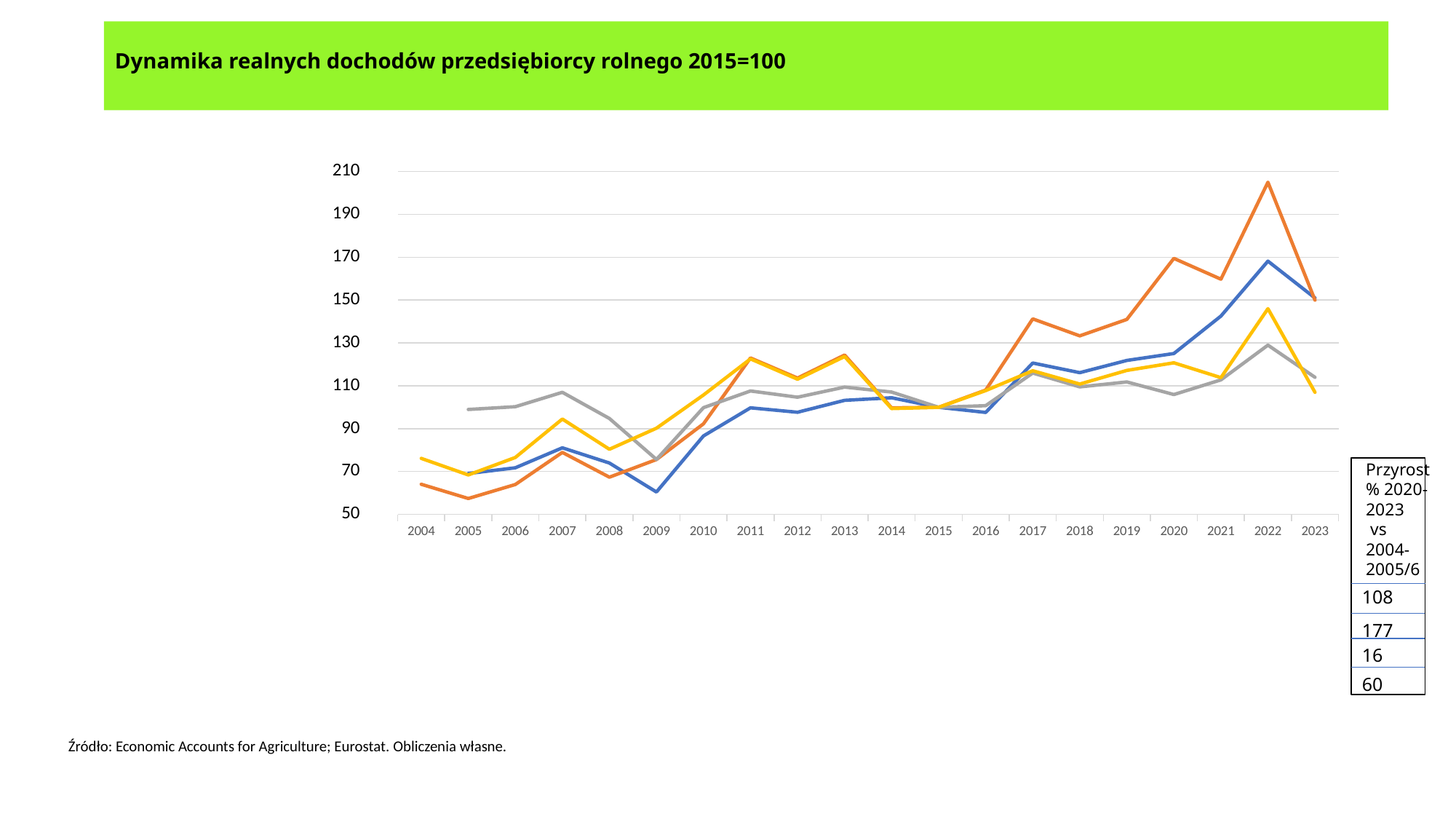
How many years are shown on the x axis of the chart? 20 In 2022, which line is higher: the orange line or the blue line? the orange line In which year does the orange line reach its highest value? 2022 Is the value of the orange line in 2022 greater or less than 190? greater In which year does the orange line reach its lowest value? 2005 Does the orange line rise or fall between 2016 and 2020? rise In which year does the blue line reach its lowest value? 2009 Is the value of the blue line in 2009 greater or less than 70? less How many lines are plotted on the chart? 4 Is the value of the blue line in 2022 greater or less than 150? greater What kind of chart is shown on the slide? line chart What is the title of the chart? Dynamika realnych dochodów przedsiębiorcy rolnego 2015=100